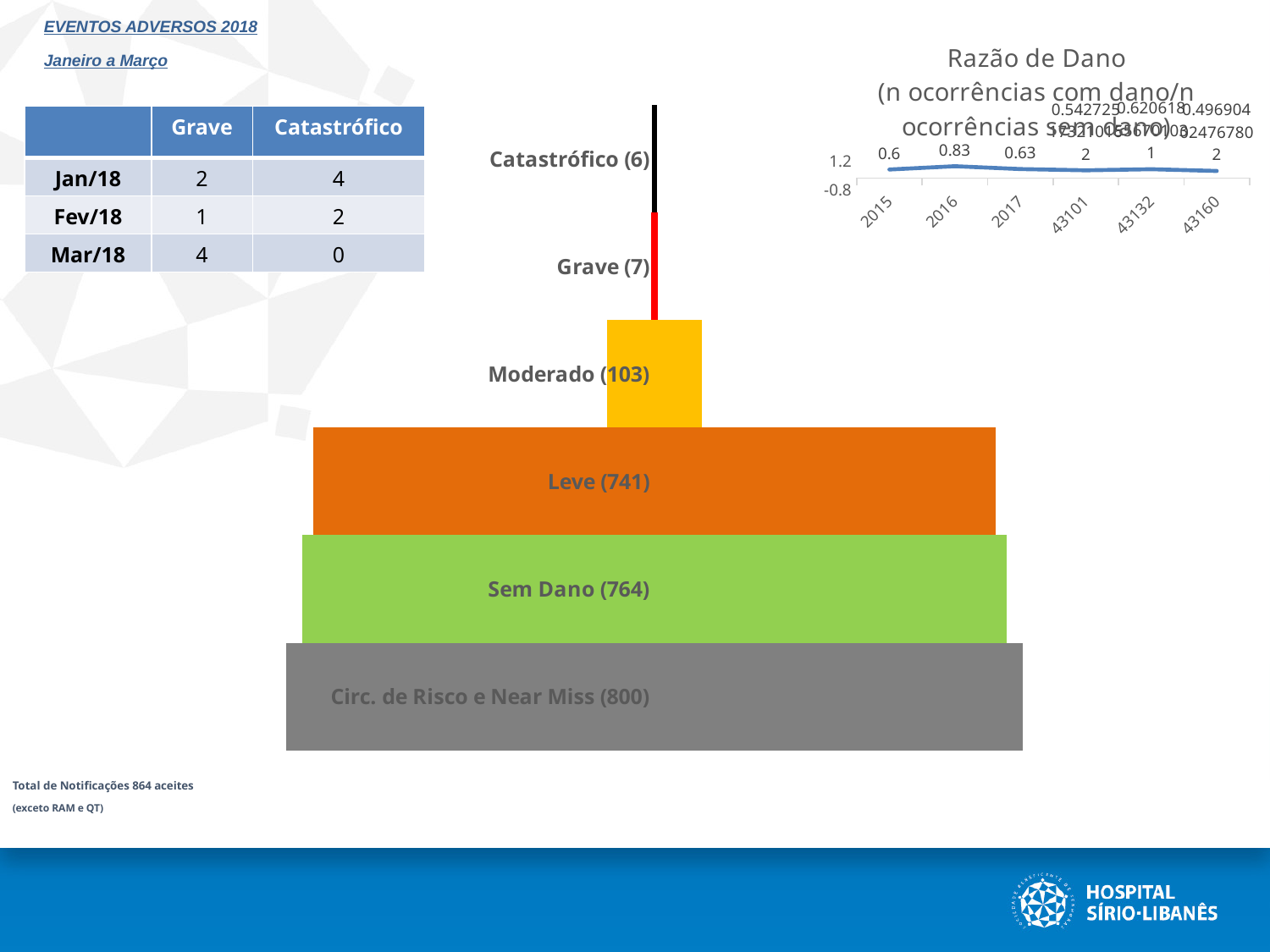
In the 'Razão de Dano' chart, what is the value for 2015? 0.6 In the pyramid chart, which category has the lowest value? Catastrófico What kind of chart is the 'Razão de Dano' chart? line chart In the pyramid chart, which category has the highest value? Circ. de Risco e Near Miss In the pyramid chart, what is the difference between the values for Sem Dano and Leve? 23 In the pyramid chart, what is the value for Leve? 741 In the pyramid chart, what is the value for Sem Dano? 764 How many categories does the pyramid chart show? 6 In the pyramid chart, what is the difference between the values for Circ. de Risco e Near Miss and Sem Dano? 36 In the pyramid chart, which is larger, the value for Grave or the value for Catastrófico? Grave In the pyramid chart, what is the value for Moderado? 103 In the 'Razão de Dano' chart, what is the value for 2016? 0.83